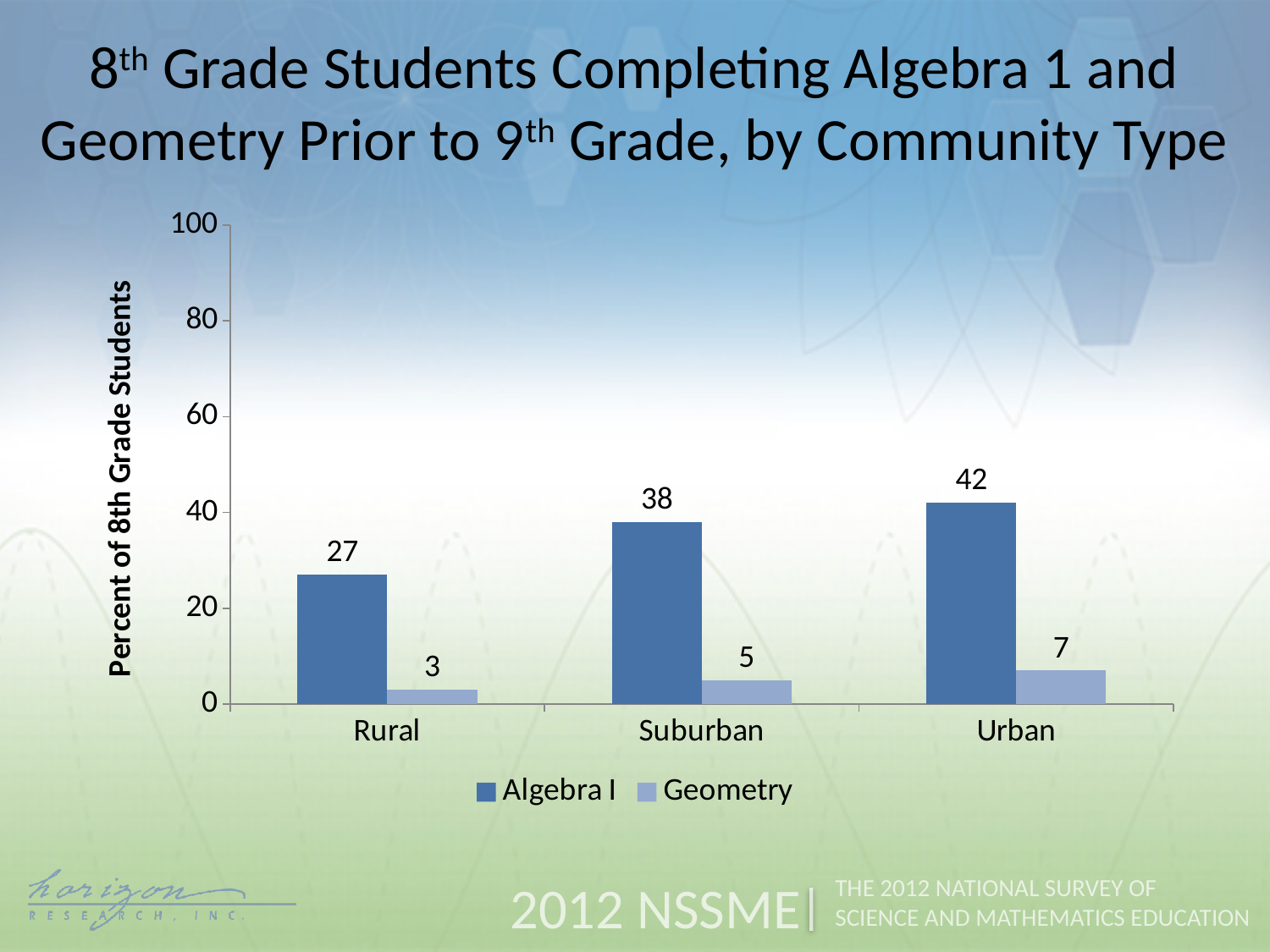
What is the difference between the Algebra I values for Urban and Rural? 15 What is the label of the y axis? Percent of 8th Grade Students Is the Algebra I value for Urban greater or less than 40? greater Which community type has the lowest Geometry value? Rural What percent of 8th grade students in rural communities completed Algebra I? 27 What is the Geometry value for Urban? 7 What is the Algebra I value for Suburban? 38 Is the Algebra I value for Suburban larger than the Algebra I value for Rural? Yes How many community types are shown on the x axis? 3 What kind of chart is shown on the slide? Bar chart Which community type has the highest Algebra I value? Urban How many series does the legend list? 2